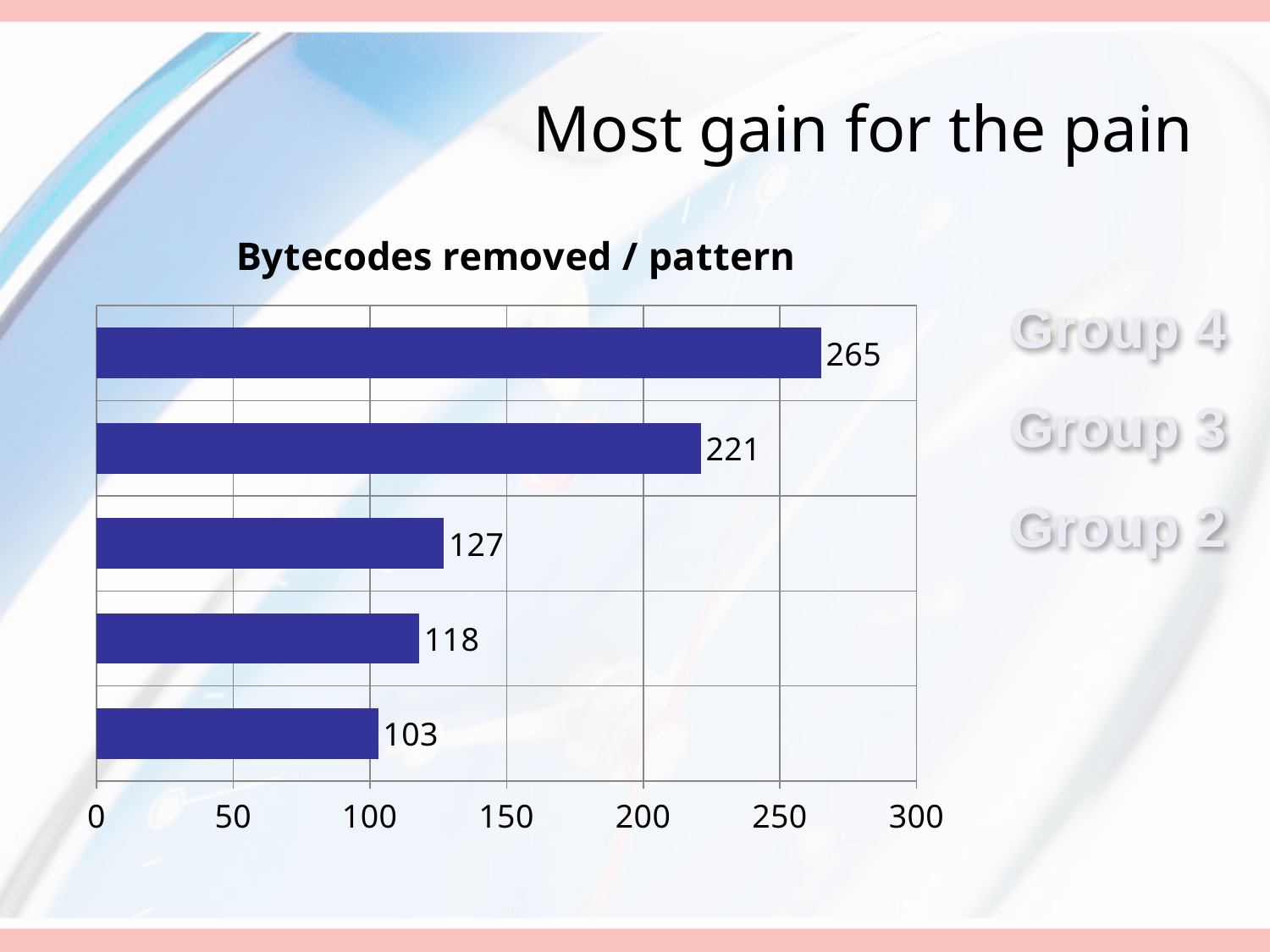
What is the value of the bottom bar in the chart? 103 What is the difference between the top bar (265) and the second bar (221)? 44 What is the difference between the third bar (127) and the fourth bar (118)? 9 What kind of chart is shown on the slide? Bar chart Do the bar values increase or decrease going from the top bar to the bottom bar? Decrease How many bars are plotted in the chart? 5 What is the lowest value shown in the chart? 103 What is the value of the third bar from the top? 127 What is the title of the chart? Bytecodes removed / pattern What is the highest value shown in the chart? 265 What is the value of the top bar in the chart? 265 Which is larger, the second bar from the top or the fourth bar from the top? The second bar from the top (221)